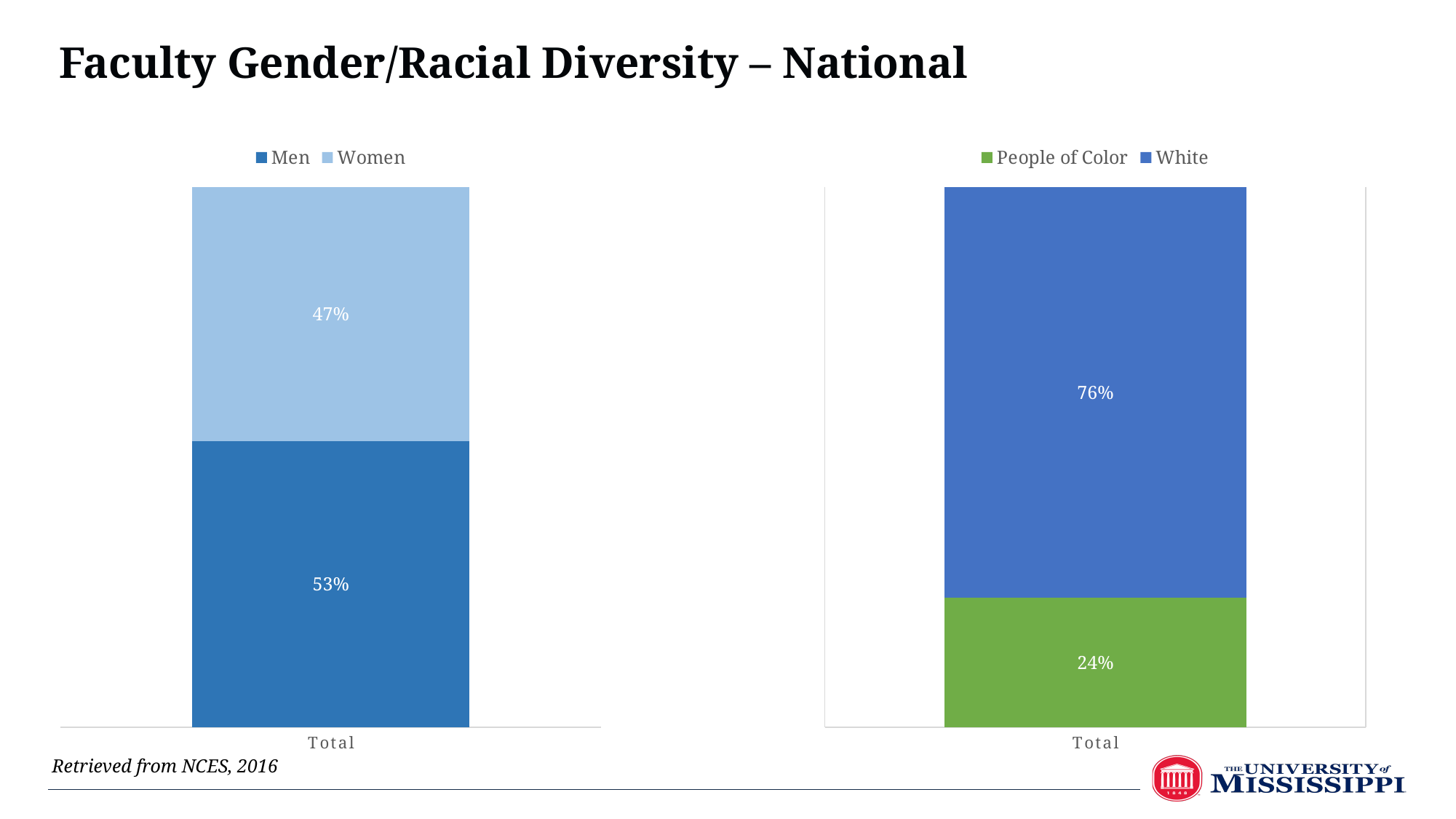
In the right chart (People of Color/White), what is the value for White? 76% In the right chart (People of Color/White), what is the difference between the White and People of Color values? 52% In the right chart (People of Color/White), what is the value for People of Color? 24% What kind of chart is the right chart (People of Color/White)? Stacked bar chart How many series does the legend of the left chart list? 2 In the left chart (Men/Women), what is the value for Men? 53% In the left chart (Men/Women), which series has the larger share, Men or Women? Men In the right chart, what colour is the People of Color segment? Green In the right chart (People of Color/White), what is the total of the stacked bar? 100% In the right chart (People of Color/White), which series has the smaller share? People of Color In the left chart (Men/Women), what is the value for Women? 47% In the left chart (Men/Women), what is the difference between the Men and Women values? 6%